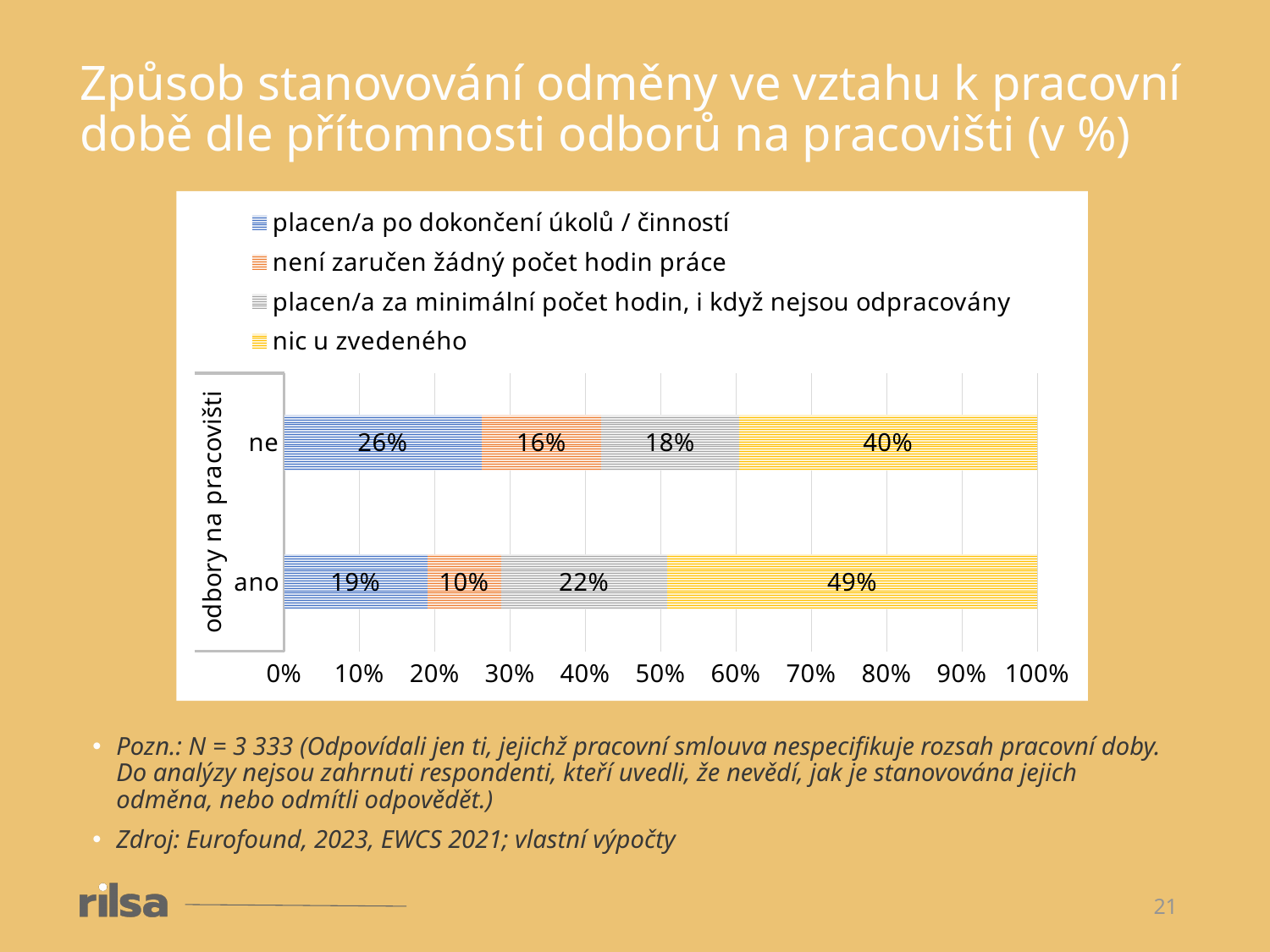
What is the value for 'placen/a za minimální počet hodin, i když nejsou odpracovány' in the 'ne' category? 18% What is the difference between the 'nic u zvedeného' values for 'ano' and 'ne'? 9% What is the value for 'placen/a po dokončení úkolů / činností' in the 'ne' category? 26% What is the value for 'nic u zvedeného' in the 'ano' category? 49% How many categories are shown on the vertical axis? 2 Which series has the largest share in the 'ano' bar? nic u zvedeného What kind of chart is shown on the slide? stacked bar chart How many series does the legend list? 4 Which category has the larger value for 'placen/a za minimální počet hodin, i když nejsou odpracovány', 'ne' or 'ano'? ano Which series has the smallest share in the 'ne' bar? není zaručen žádný počet hodin práce What is the value for 'není zaručen žádný počet hodin práce' in the 'ano' category? 10% What is the total of the 'ne' stacked bar? 100%